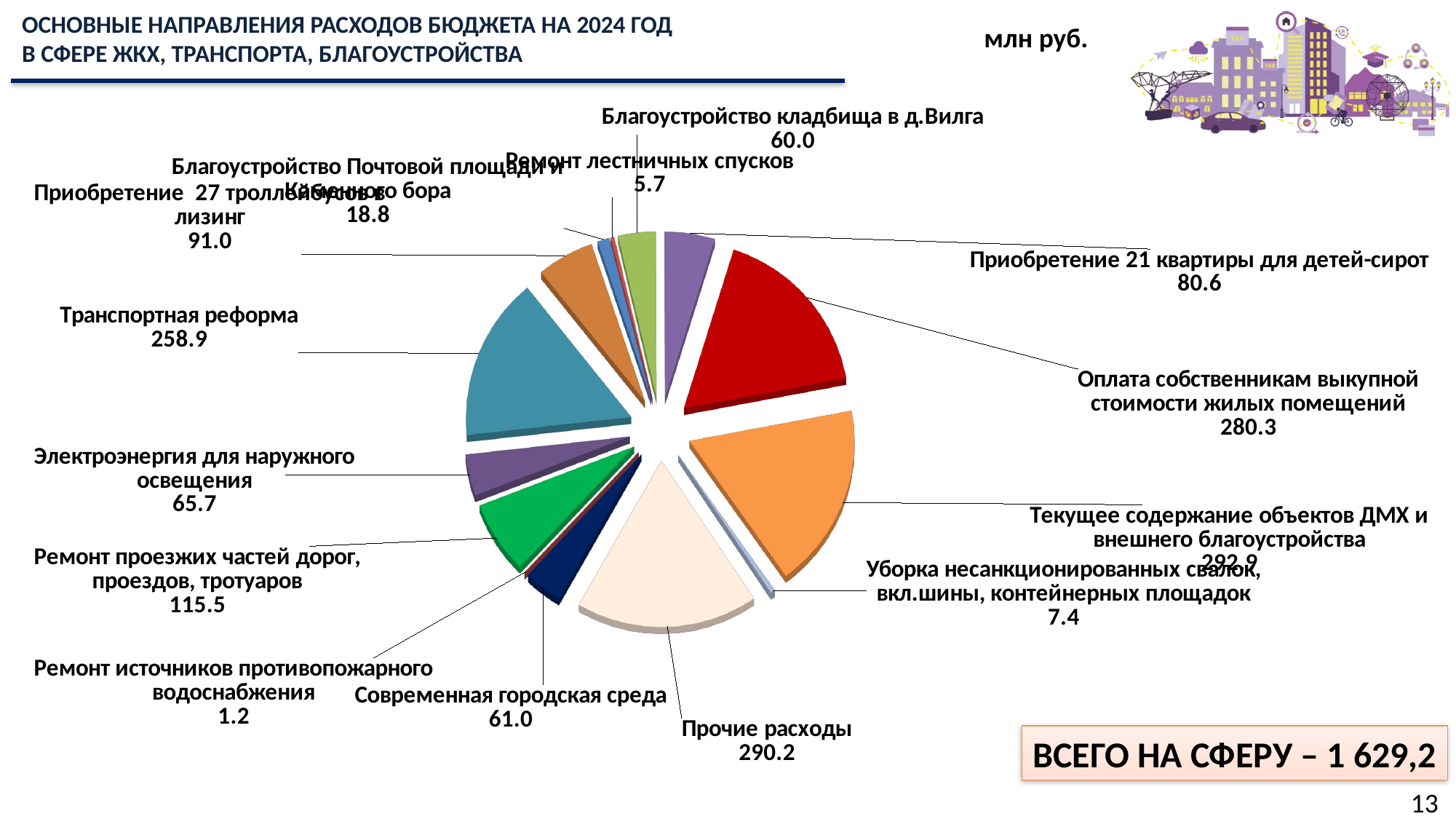
What is the value for Прочие расходы? 290.2 How many slices does the pie chart have? 14 In what units are the values on the chart given? млн руб. What is the value for Оплата собственникам выкупной стоимости жилых помещений? 280.3 What is the value for Транспортная реформа? 258.9 What is the value for Приобретение 21 квартиры для детей-сирот? 80.6 Which category has the smallest value in the pie chart? Ремонт источников противопожарного водоснабжения What type of chart is shown on the slide? pie chart What is the difference between Приобретение 27 троллейбусов в лизинг and Электроэнергия для наружного освещения? 25.3 Which is larger: Благоустройство кладбища в д.Вилга or Уборка несанкционированных свалок, вкл.шины, контейнерных площадок? Благоустройство кладбища в д.Вилга What is the value for Ремонт проезжих частей дорог, проездов, тротуаров? 115.5 What is the difference between Транспортная реформа and Ремонт проезжих частей дорог, проездов, тротуаров? 143.4